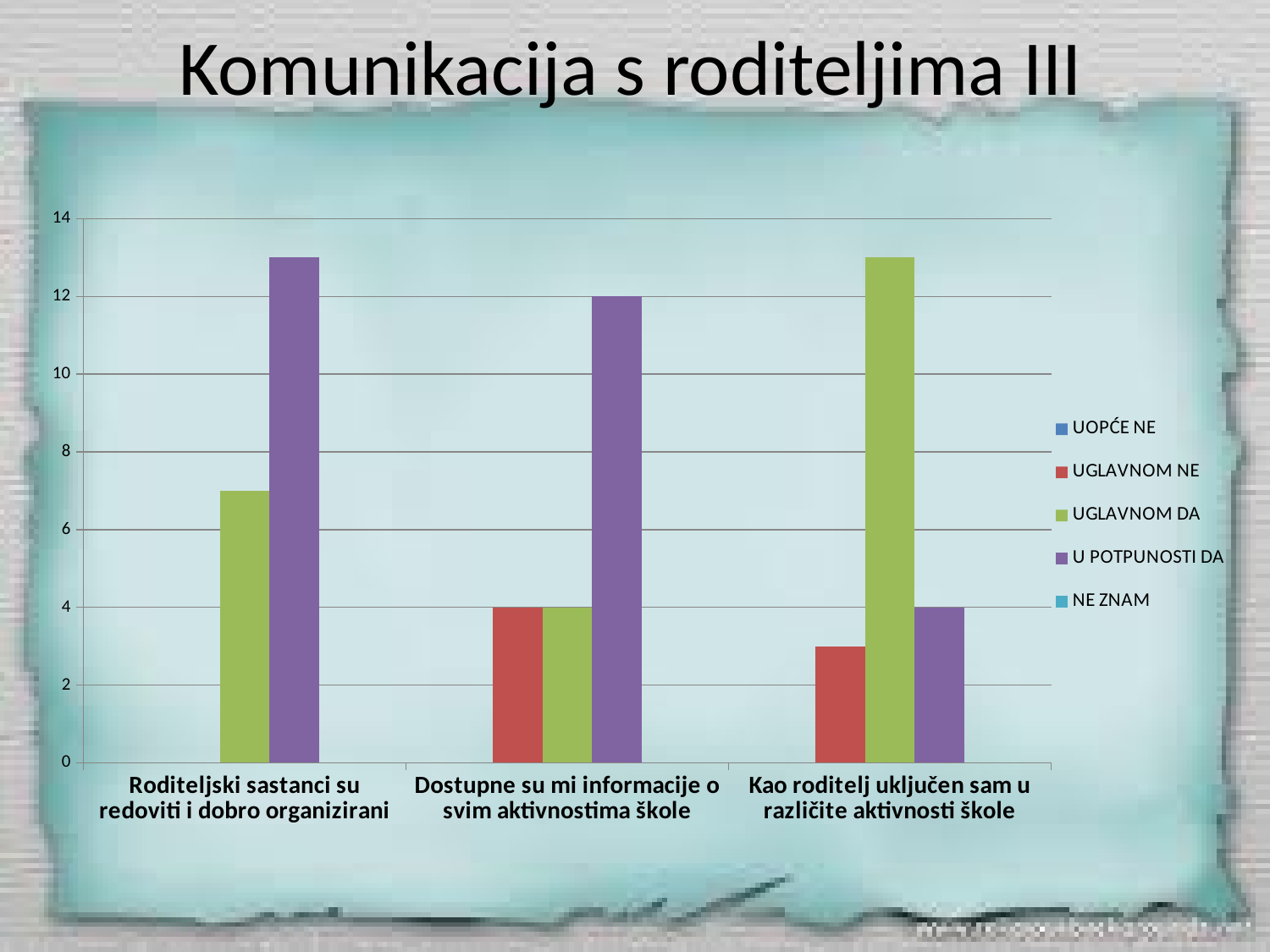
How many categories are shown on the x axis? 3 For "Dostupne su mi informacije o svim aktivnostima škole", what is the difference between U POTPUNOSTI DA and UGLAVNOM NE? 8 What is the value of UGLAVNOM NE for "Dostupne su mi informacije o svim aktivnostima škole"? 4 For "Roditeljski sastanci su redoviti i dobro organizirani", which is larger: UGLAVNOM DA or U POTPUNOSTI DA? U POTPUNOSTI DA Which series has the highest value for "Kao roditelj uključen sam u različite aktivnosti škole"? UGLAVNOM DA How many series does the legend list? 5 Is the value of UGLAVNOM DA for "Roditeljski sastanci su redoviti i dobro organizirani" greater or less than 8? less Is the value of U POTPUNOSTI DA for "Roditeljski sastanci su redoviti i dobro organizirani" greater or less than 12? greater Is the value of UGLAVNOM NE for "Kao roditelj uključen sam u različite aktivnosti škole" greater or less than 4? less What is the value of U POTPUNOSTI DA for "Kao roditelj uključen sam u različite aktivnosti škole"? 4 What is the value of U POTPUNOSTI DA for "Dostupne su mi informacije o svim aktivnostima škole"? 12 What type of chart is shown on the slide? bar chart